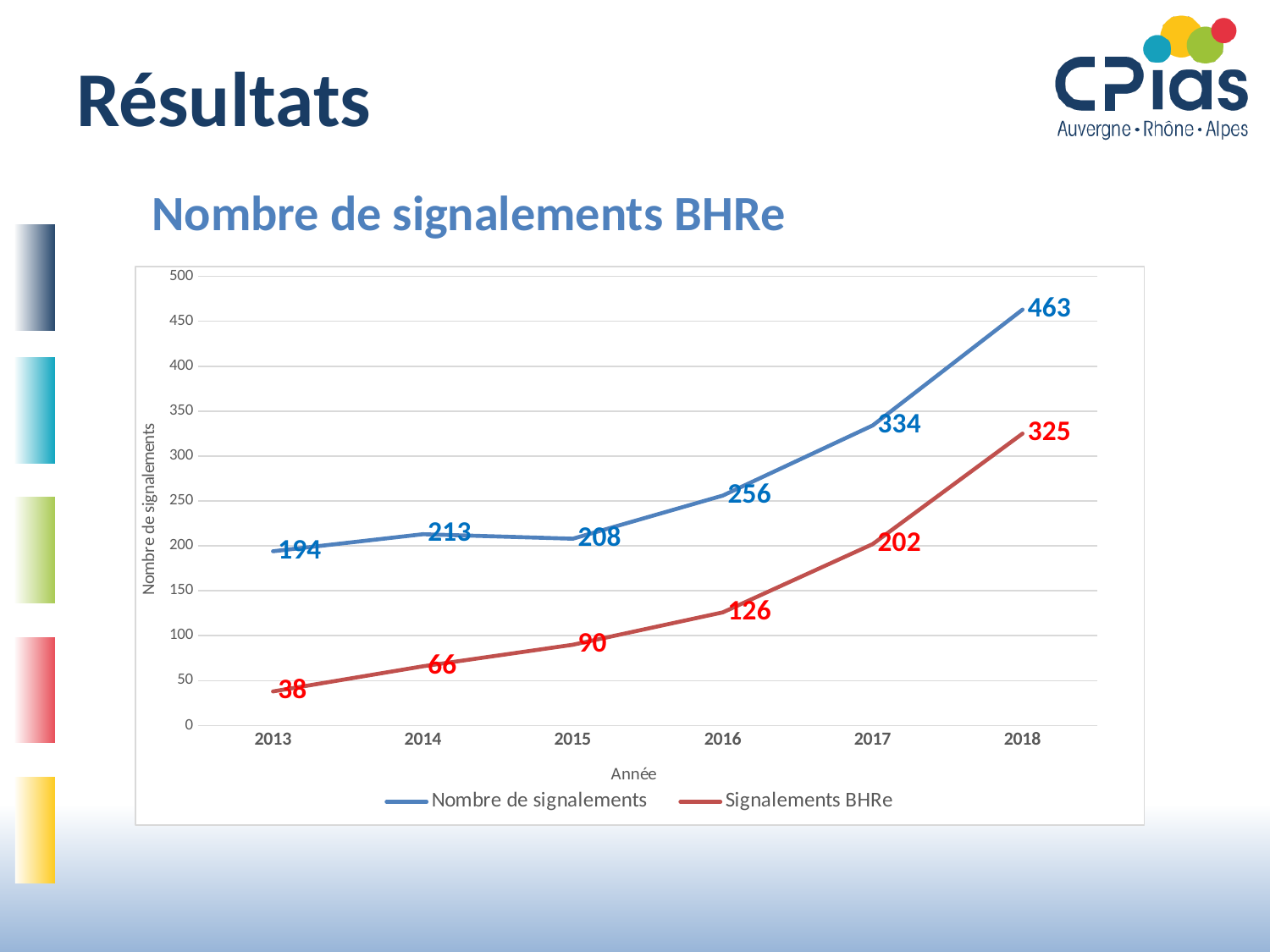
What is the value of Signalements BHRe in 2015? 90 In which year is Signalements BHRe lowest? 2013 What is the difference between Nombre de signalements and Signalements BHRe in 2018? 138 What kind of chart is shown? line chart How many years are shown on the x axis? 6 What is the title of the chart? Nombre de signalements BHRe What is the value of Nombre de signalements in 2013? 194 Which is larger in 2016: Nombre de signalements or Signalements BHRe? Nombre de signalements Does Signalements BHRe rise or fall from 2013 to 2018? rise What is the value of Nombre de signalements in 2018? 463 How many series does the legend list? 2 In which year is Nombre de signalements highest? 2018